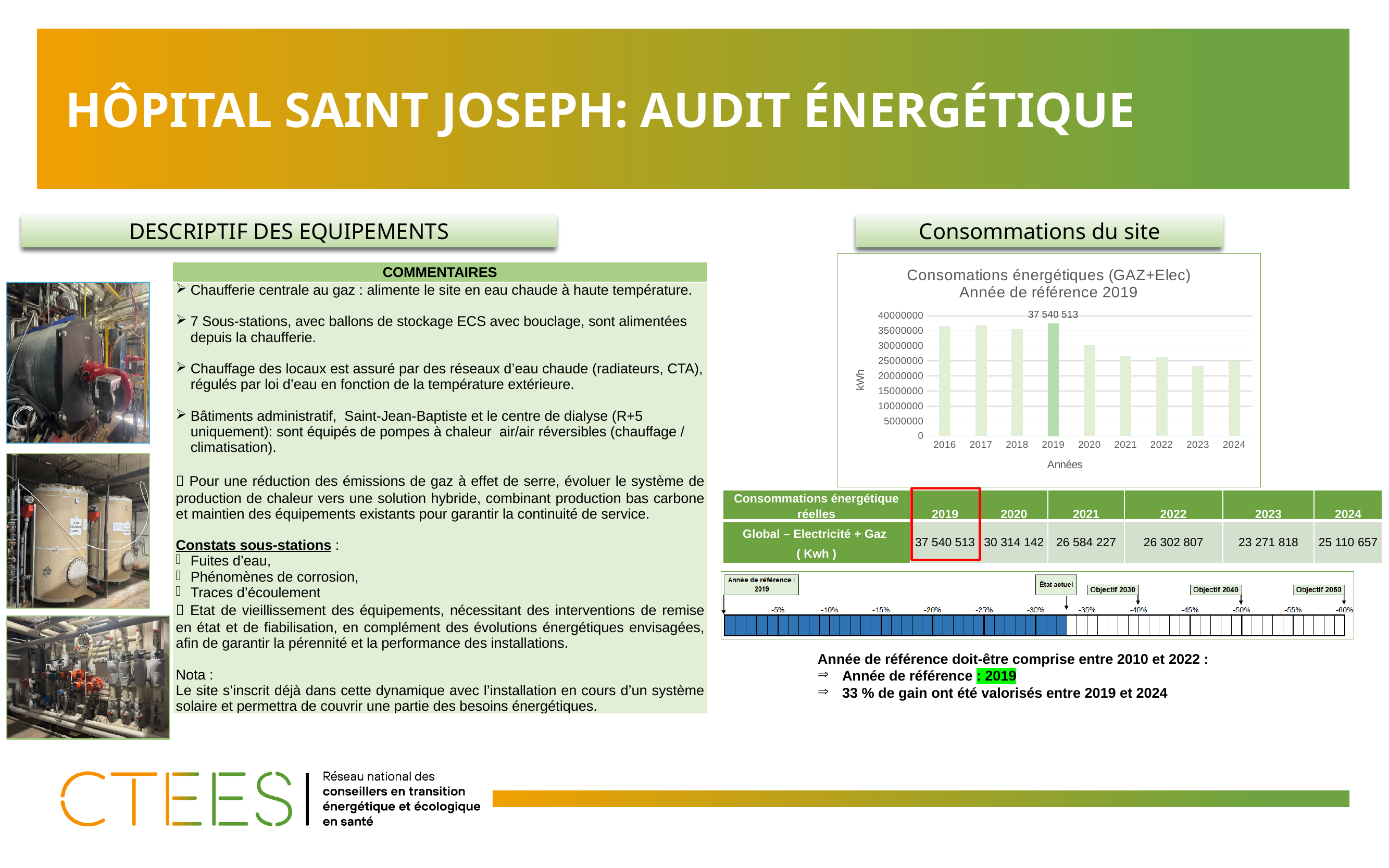
Do the values in the energy consumption chart generally rise or fall from 2016 to 2024? fall What unit is shown on the y axis of the energy consumption chart? kWh In the energy consumption chart, which year has the larger value, 2020 or 2021? 2020 Is the value for 2020 in the energy consumption chart greater or less than 35000000? less Is the value for 2021 in the energy consumption chart greater or less than 25000000? greater Which year has the highest bar in the energy consumption chart? 2019 Which year has the lowest bar in the energy consumption chart? 2023 What kind of chart is used to show the site's energy consumption? bar chart Is the value for 2023 in the energy consumption chart greater or less than 25000000? less How many years are shown on the x axis of the energy consumption chart? 9 What is the value printed on the bar for 2019 in the energy consumption chart? 37 540 513